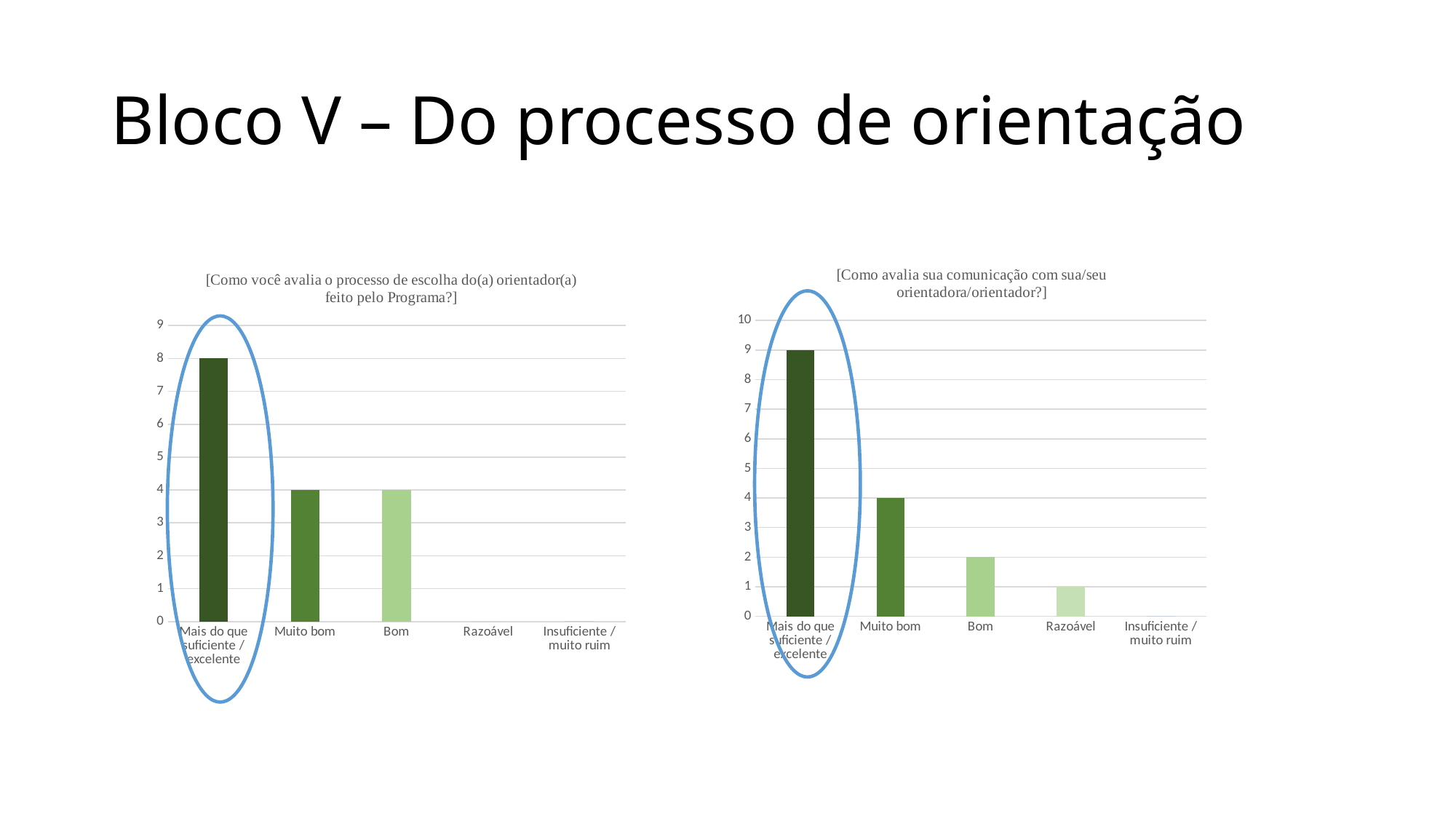
In the left chart, which category has the highest value? Mais do que suficiente / excelente In the right chart, what is the value for 'Bom'? 2 In the right chart, which is larger, 'Muito bom' or 'Bom'? Muito bom In the left chart, what is the value for 'Muito bom'? 4 What is the title of the left chart? [Como você avalia o processo de escolha do(a) orientador(a) feito pelo Programa?] In the left chart, how many categories are shown on the x axis? 5 In the right chart, what is the value for 'Mais do que suficiente / excelente'? 9 What kind of chart is the right chart? bar chart In the right chart, what is the value for 'Razoável'? 1 In the right chart, do the values rise or fall from left to right along the x axis? fall In the left chart, what is the value for 'Mais do que suficiente / excelente'? 8 In the left chart, what is the difference between 'Mais do que suficiente / excelente' and 'Bom'? 4